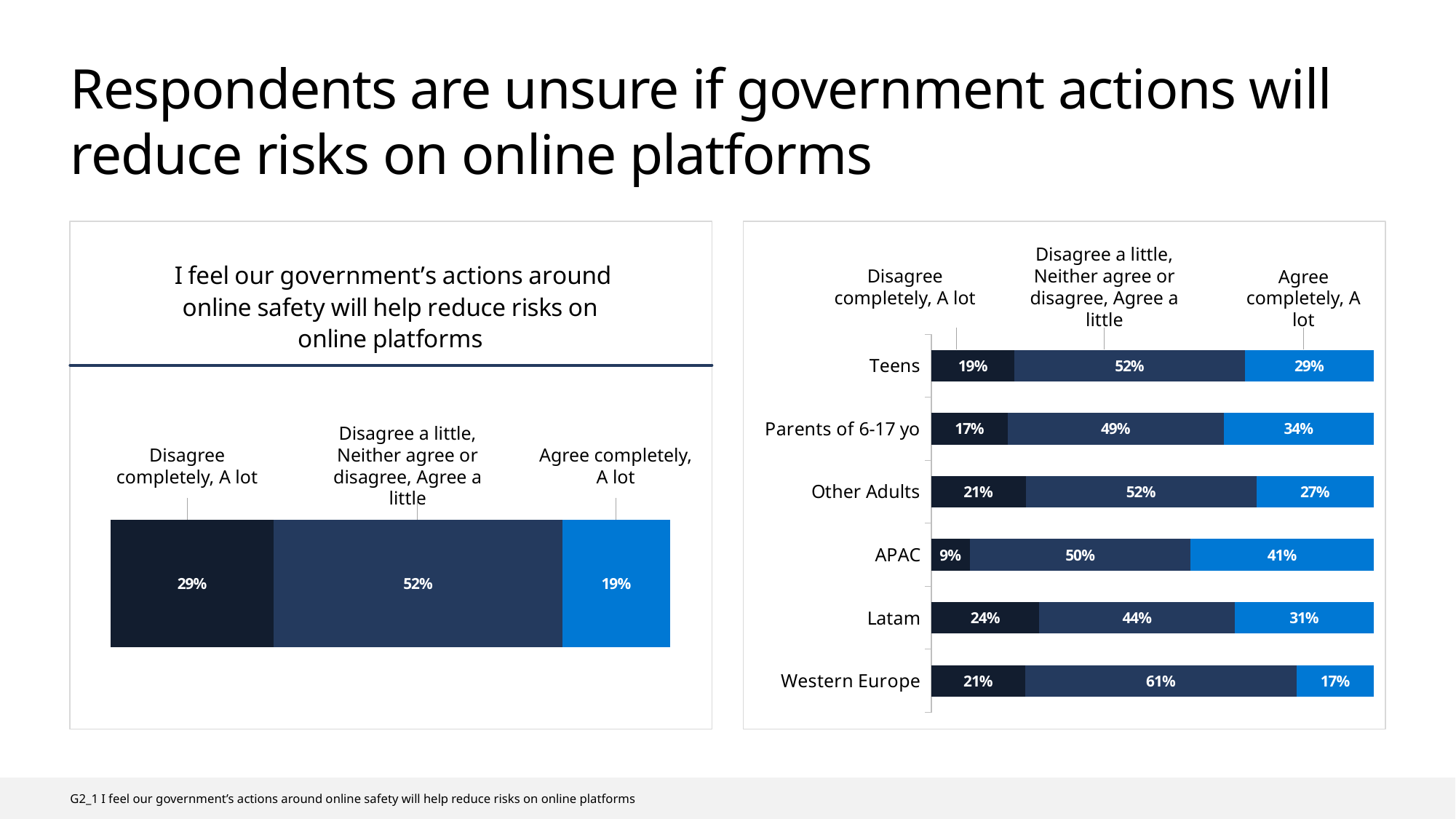
In the left chart, what percentage of respondents answered 'Disagree completely, A lot'? 29% In the right chart, what is the difference between the 'Agree completely, A lot' shares for Parents of 6-17 yo and Teens? 5% In the right chart, which is larger: the 'Disagree completely, A lot' share for Latam or for Other Adults? Latam How many groups are shown in the right chart? 6 What is the title of the left chart? I feel our government's actions around online safety will help reduce risks on online platforms In the right chart, which group has the lowest share of 'Disagree completely, A lot'? APAC In the right chart, which group has the highest share of 'Agree completely, A lot'? APAC In the right chart, what percentage of Western Europe respondents answered 'Disagree a little, Neither agree or disagree, Agree a little'? 61% In the left chart, what percentage of respondents answered 'Agree completely, A lot'? 19% How many response categories does the right chart show for each group? 3 What type of chart is the right chart? Stacked bar chart In the right chart, what percentage of APAC respondents answered 'Agree completely, A lot'? 41%